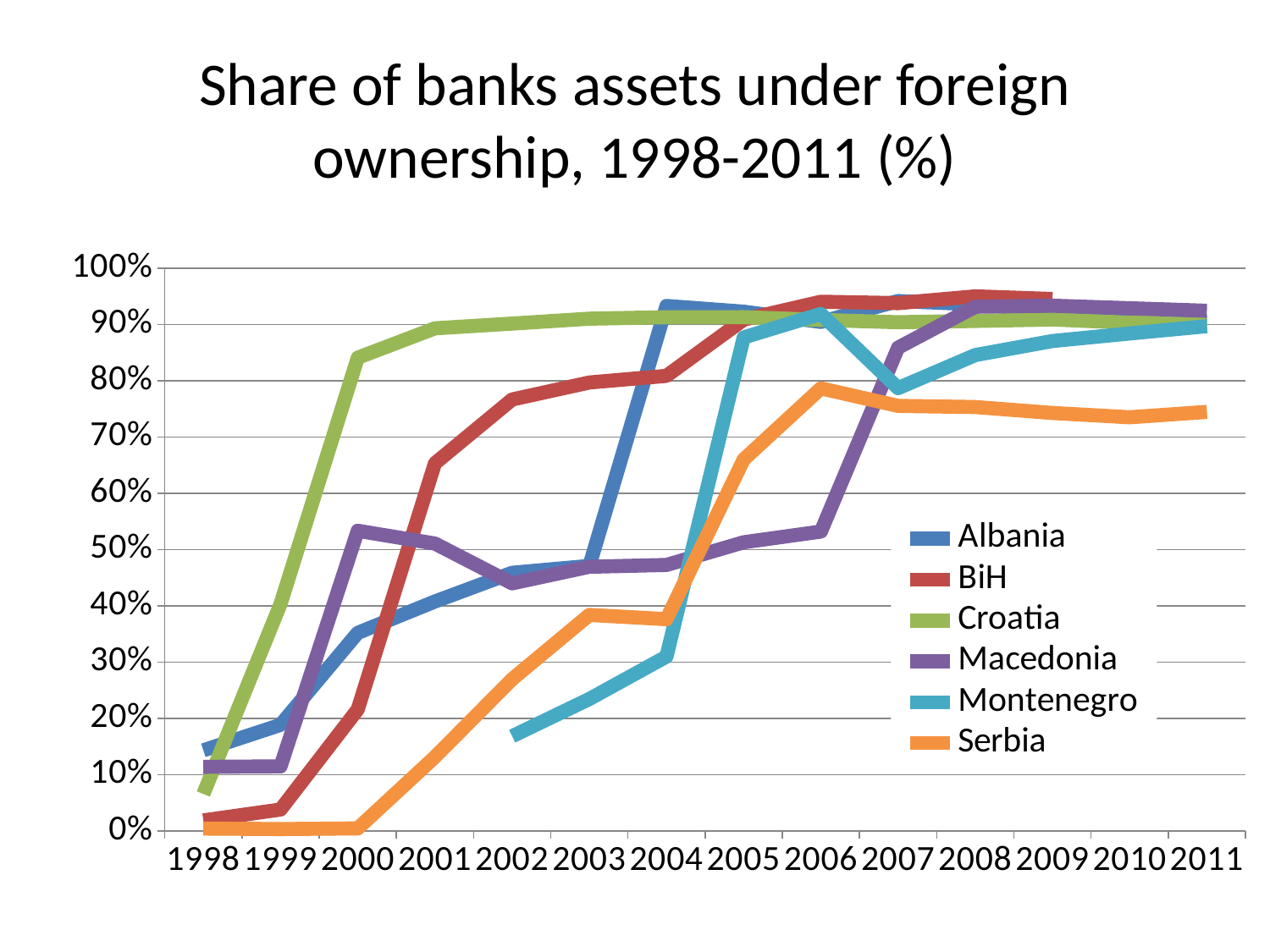
In 2000, which is larger, the value for Croatia or the value for Albania? Croatia Which country has the lowest share in 2011? Serbia Does the value for Croatia rise or fall from 1998 to 2001? rise Is the value for Serbia in 2011 greater or less than 80%? less Which country has the highest share in 2001? Croatia What kind of chart is shown on the slide? Line chart How many series does the legend list? 6 Is the value for Croatia in 2000 greater or less than 80%? greater Is the value for Montenegro in 2002 greater or less than 20%? less Which series in the legend is shown in orange? Serbia How many years are shown on the x axis? 14